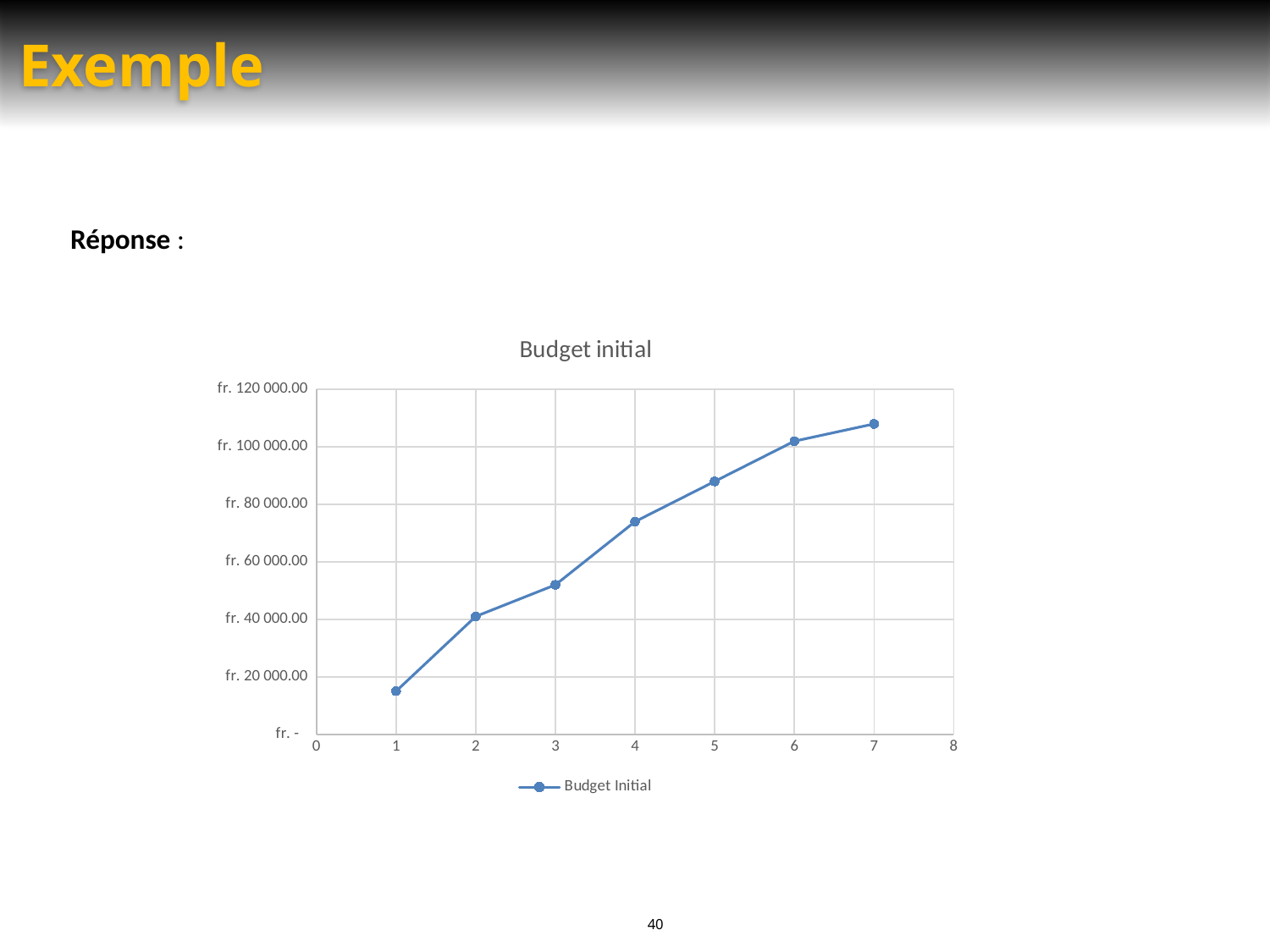
How many series does the legend list? 1 Which is larger, the value at x = 3 or the value at x = 5? x = 5 Is the value at x = 1 greater or less than fr. 20 000.00? less What is the name of the series shown in the legend? Budget Initial How many data points are plotted on the line? 7 What kind of chart is shown on the slide? line chart Do the values rise or fall as x increases from 1 to 7? rise At which x value is the plotted value lowest? 1 At which x value is the plotted value highest? 7 What is the title of the chart? Budget initial Is the value at x = 4 greater or less than fr. 80 000.00? less